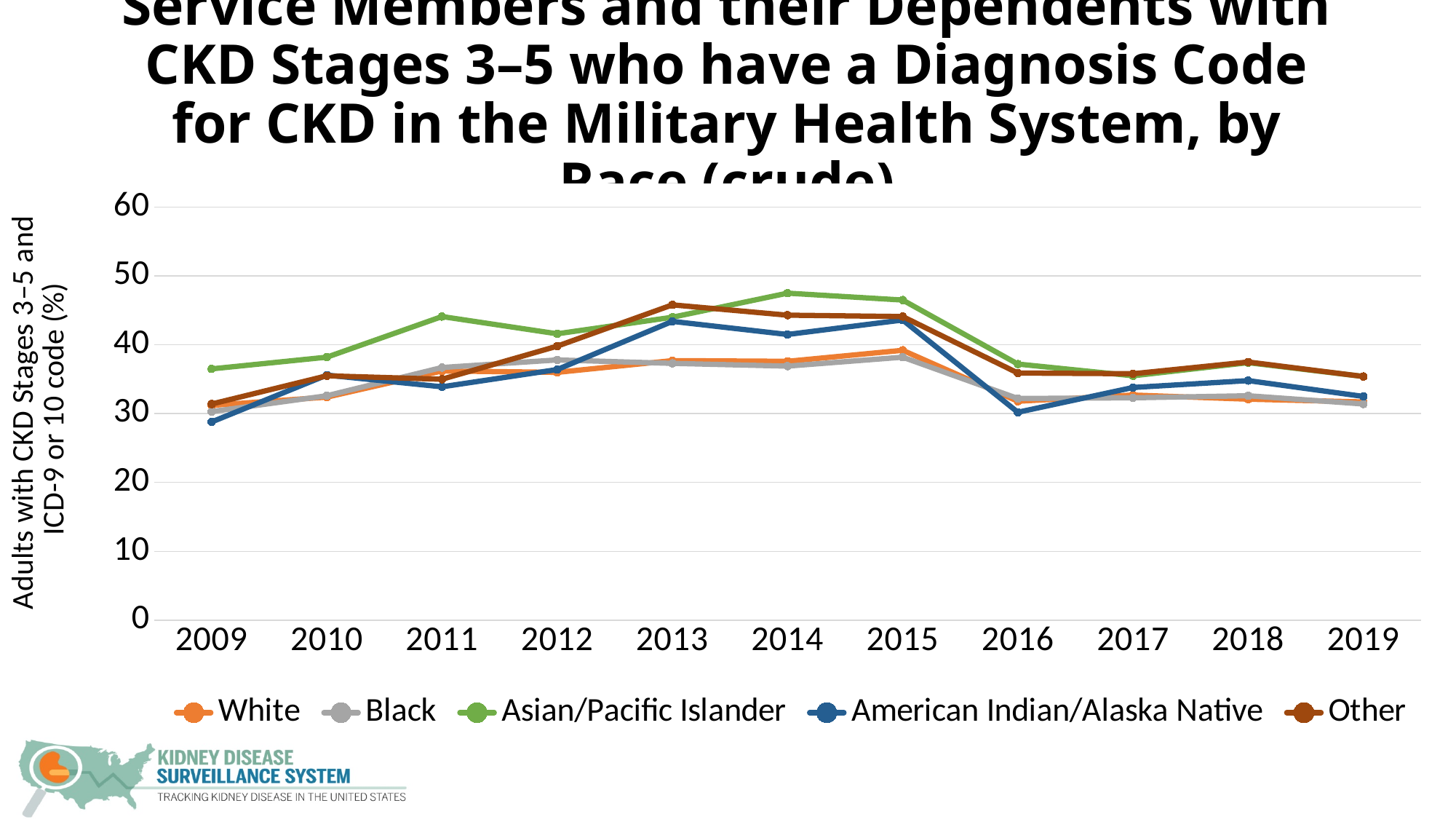
Is the value for Other in 2013 greater or less than 40? greater What kind of chart is shown on the slide? line chart Is the value for Asian/Pacific Islander in 2014 greater or less than 40? greater In 2014, which is higher: Asian/Pacific Islander or American Indian/Alaska Native? Asian/Pacific Islander In 2016, which is higher: Other or American Indian/Alaska Native? Other Is the value for American Indian/Alaska Native in 2009 greater or less than 30? less Does the Asian/Pacific Islander series rise or fall from 2015 to 2016? fall How many years are plotted along the x axis? 11 Which series has the highest value in 2011? Asian/Pacific Islander How many series does the legend list? 5 In which year does the Other series reach its highest value? 2013